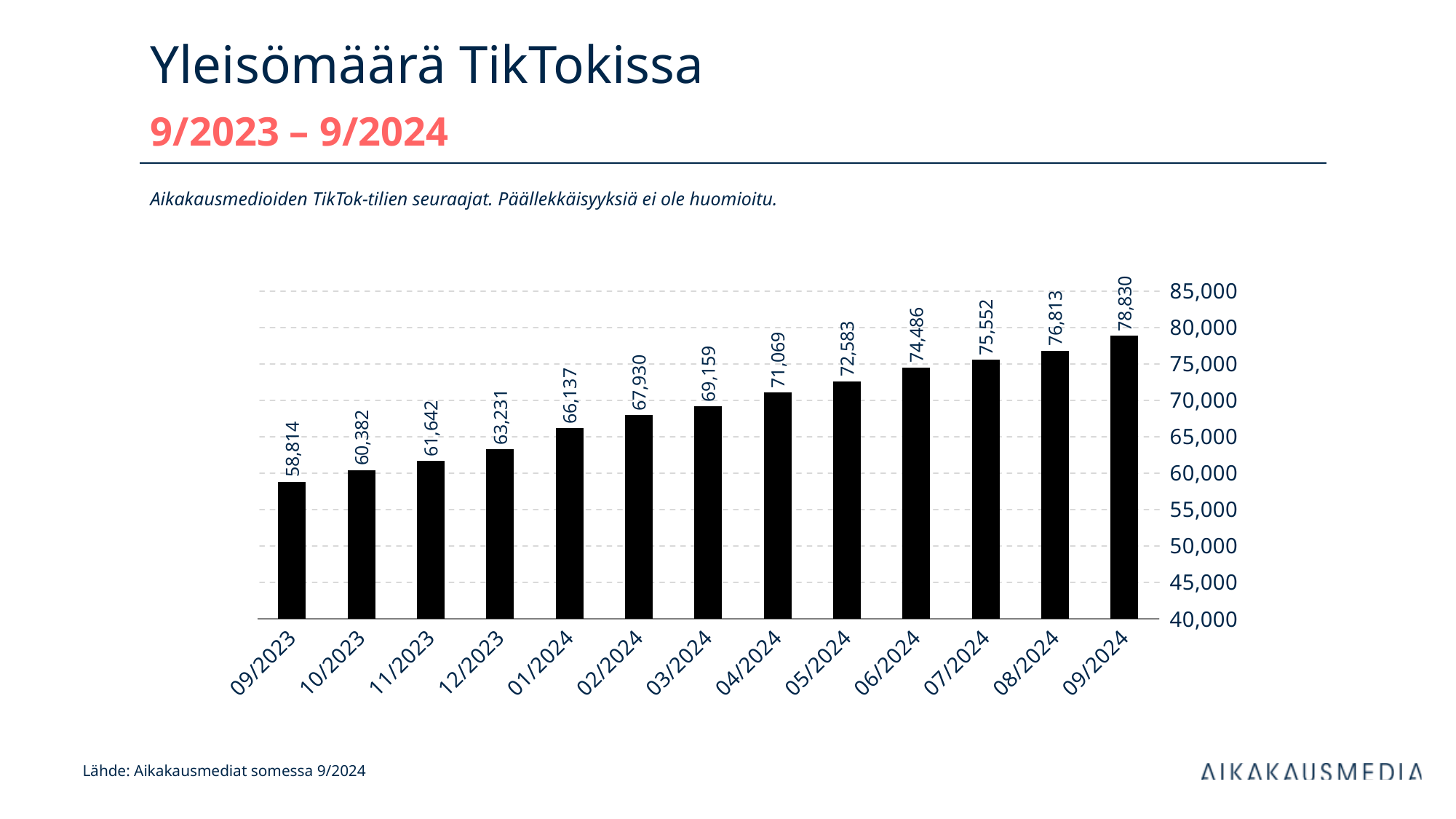
What is the value for 09/2024? 78,830 Which is larger, the value for 06/2024 or the value for 04/2024? 06/2024 Do the values rise or fall from 09/2023 to 09/2024? rise How many months are shown on the x axis? 13 What is the difference between the values for 01/2024 and 12/2023? 2,906 What is the value for 09/2023? 58,814 Is the value for 05/2024 greater or less than 70,000? greater What is the difference between the values for 09/2024 and 09/2023? 20,016 What kind of chart is shown on the slide? bar chart Which month has the lowest value? 09/2023 What is the value for 03/2024? 69,159 Which month has the highest value? 09/2024